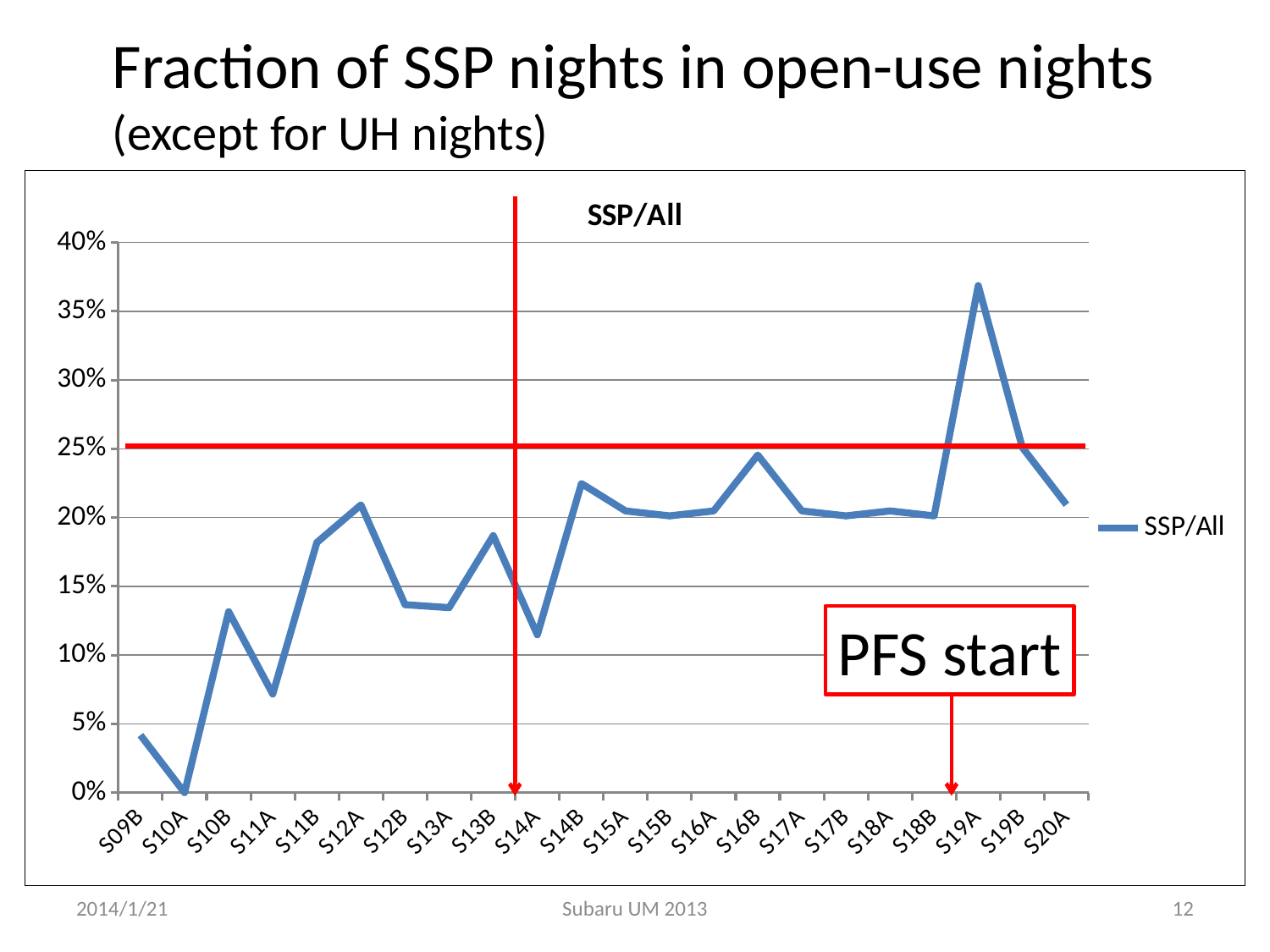
How many series does the legend list? 1 Is the SSP/All value for S19A greater or less than 35%? greater Is the SSP/All value for S09B greater or less than 5%? less Does the SSP/All value rise or fall from S19A to S20A? fall What is the SSP/All value for S10A? 0% How many semesters (categories) are plotted along the x axis? 22 What kind of chart is shown on the slide? line chart Which semester has the highest SSP/All value? S19A Which has the larger SSP/All value, S12A or S12B? S12A Which semester does the 'PFS start' annotation arrow point to? S19A Is the SSP/All value for S11A greater or less than 10%? less Which semester has the lowest SSP/All value? S10A